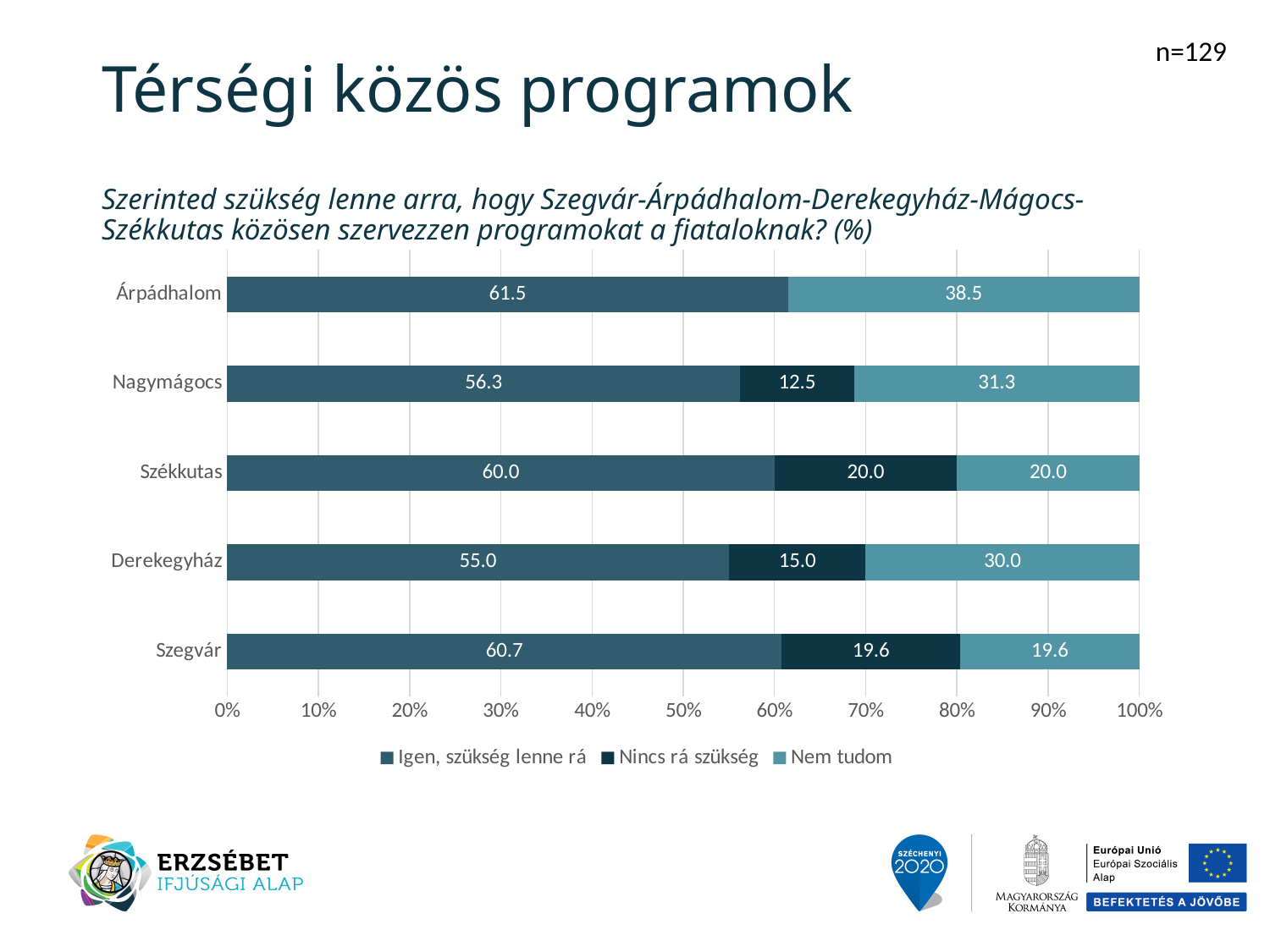
What is the value of 'Igen, szükség lenne rá' for Árpádhalom? 61.5 What kind of chart is shown on the slide? Stacked bar chart What is the value of 'Nincs rá szükség' for Nagymágocs? 12.5 What is the value of 'Nem tudom' for Derekegyház? 30.0 What is the difference between the 'Igen, szükség lenne rá' and 'Nem tudom' values for Árpádhalom? 23.0 Which settlement has the highest value for 'Igen, szükség lenne rá'? Árpádhalom Which settlement has the lowest value for 'Igen, szükség lenne rá'? Derekegyház What is the sample size (n) shown on the slide? n=129 How many settlements (categories) are shown on the chart? 5 Which settlement has the highest value for 'Nem tudom'? Árpádhalom Which is larger for Szegvár: 'Igen, szükség lenne rá' or 'Nincs rá szükség'? Igen, szükség lenne rá How many series does the legend list? 3